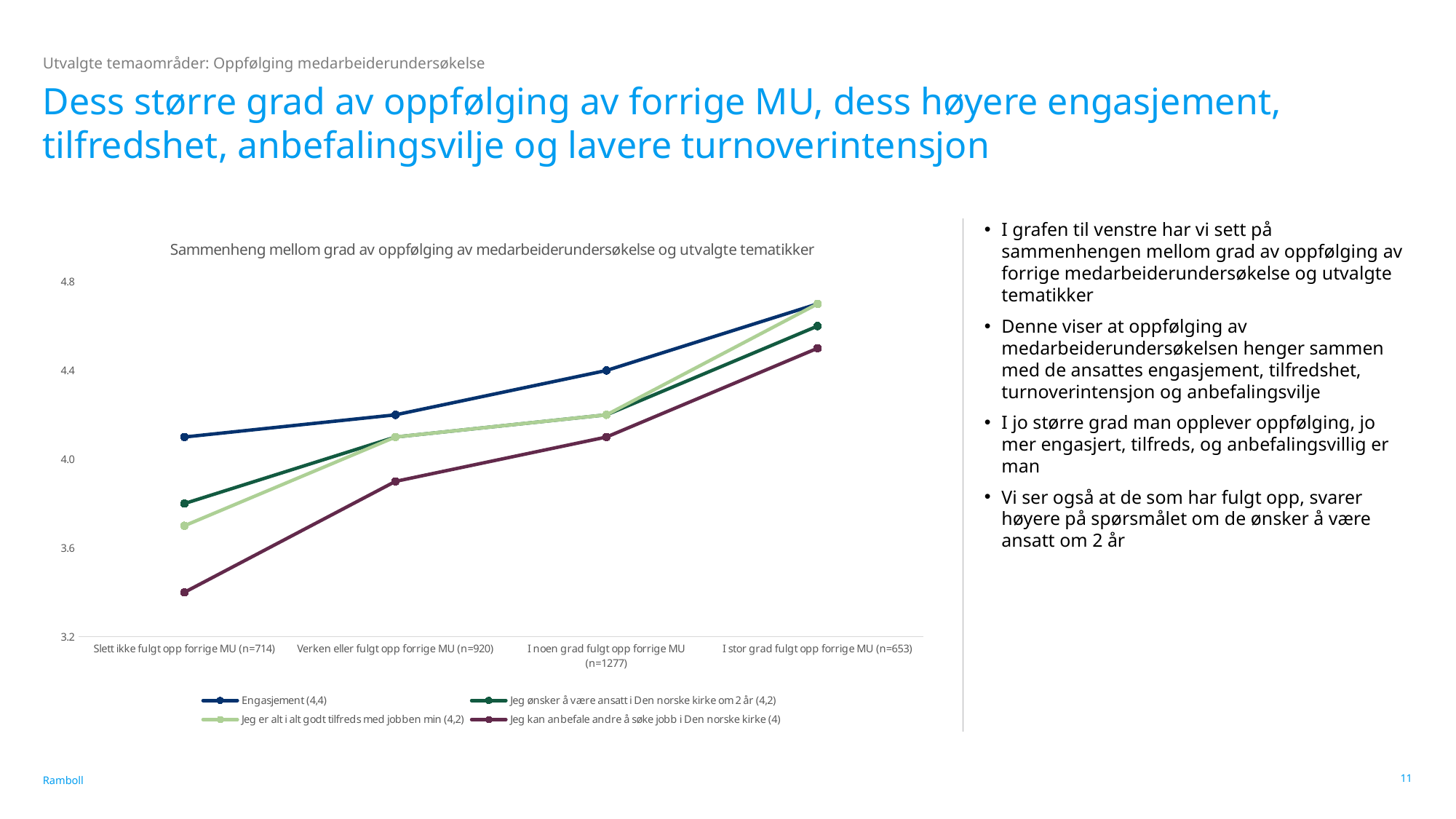
Is the value of 'Jeg kan anbefale andre å søke jobb i Den norske kirke (4)' for 'Slett ikke fulgt opp forrige MU (n=714)' greater or less than 3.6? less How many series does the chart legend list? 4 What is the sample size (n) shown for the category 'I noen grad fulgt opp forrige MU'? 1277 What is the title of the chart? Sammenheng mellom grad av oppfølging av medarbeiderundersøkelse og utvalgte tematikker Do the values of the Engasjement series rise or fall from left to right along the x axis? rise Which series has the lowest value for 'Slett ikke fulgt opp forrige MU (n=714)'? Jeg kan anbefale andre å søke jobb i Den norske kirke (4) Is the value of 'Engasjement (4,4)' for 'Slett ikke fulgt opp forrige MU (n=714)' greater or less than 4.0? greater Which series has the highest value for 'Slett ikke fulgt opp forrige MU (n=714)'? Engasjement (4,4) What kind of chart is shown on the slide? line chart How many categories are shown along the x axis of the chart? 4 For 'Verken eller fulgt opp forrige MU (n=920)', which is larger: the value for 'Engasjement (4,4)' or the value for 'Jeg kan anbefale andre å søke jobb i Den norske kirke (4)'? Engasjement (4,4) Is the value of 'Jeg kan anbefale andre å søke jobb i Den norske kirke (4)' for 'I stor grad fulgt opp forrige MU (n=653)' greater or less than 4.4? greater